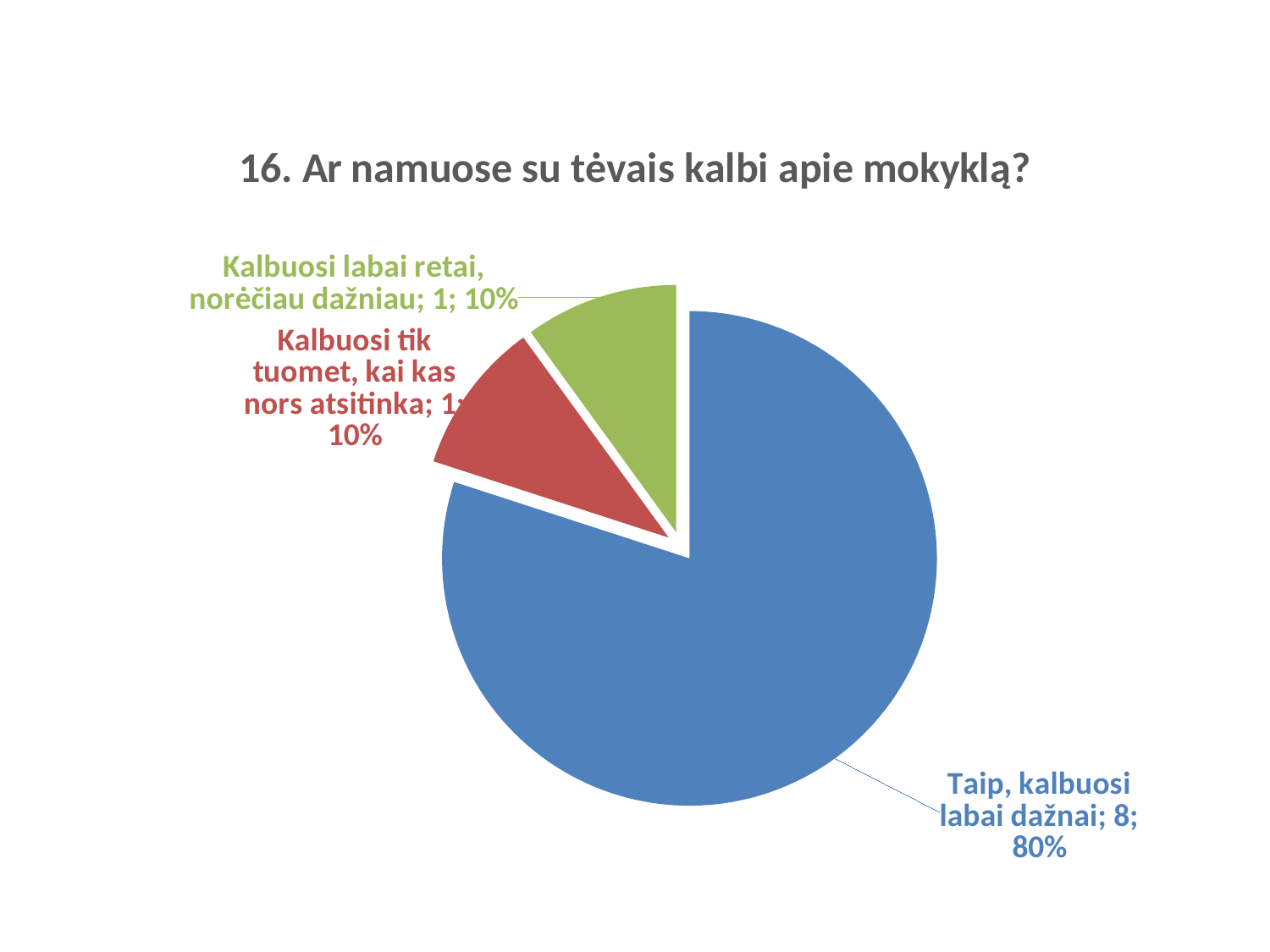
What percentage share does "Kalbuosi labai retai, norėčiau dažniau" have? 10% What is the total count across all slices of the pie? 10 What is the count for "Kalbuosi tik tuomet, kai kas nors atsitinka"? 1 What percentage share does "Taip, kalbuosi labai dažnai" have? 80% What is the title of the chart? 16. Ar namuose su tėvais kalbi apie mokyklą? What is the count for "Taip, kalbuosi labai dažnai"? 8 How many slices does the pie chart have? 3 What is the difference in count between "Taip, kalbuosi labai dažnai" and "Kalbuosi labai retai, norėčiau dažniau"? 7 Which is larger: the share for "Taip, kalbuosi labai dažnai" or for "Kalbuosi tik tuomet, kai kas nors atsitinka"? Taip, kalbuosi labai dažnai What type of chart is shown on the slide? Pie chart Which category has the largest slice of the pie? Taip, kalbuosi labai dažnai What colour is the slice for "Taip, kalbuosi labai dažnai"? Blue